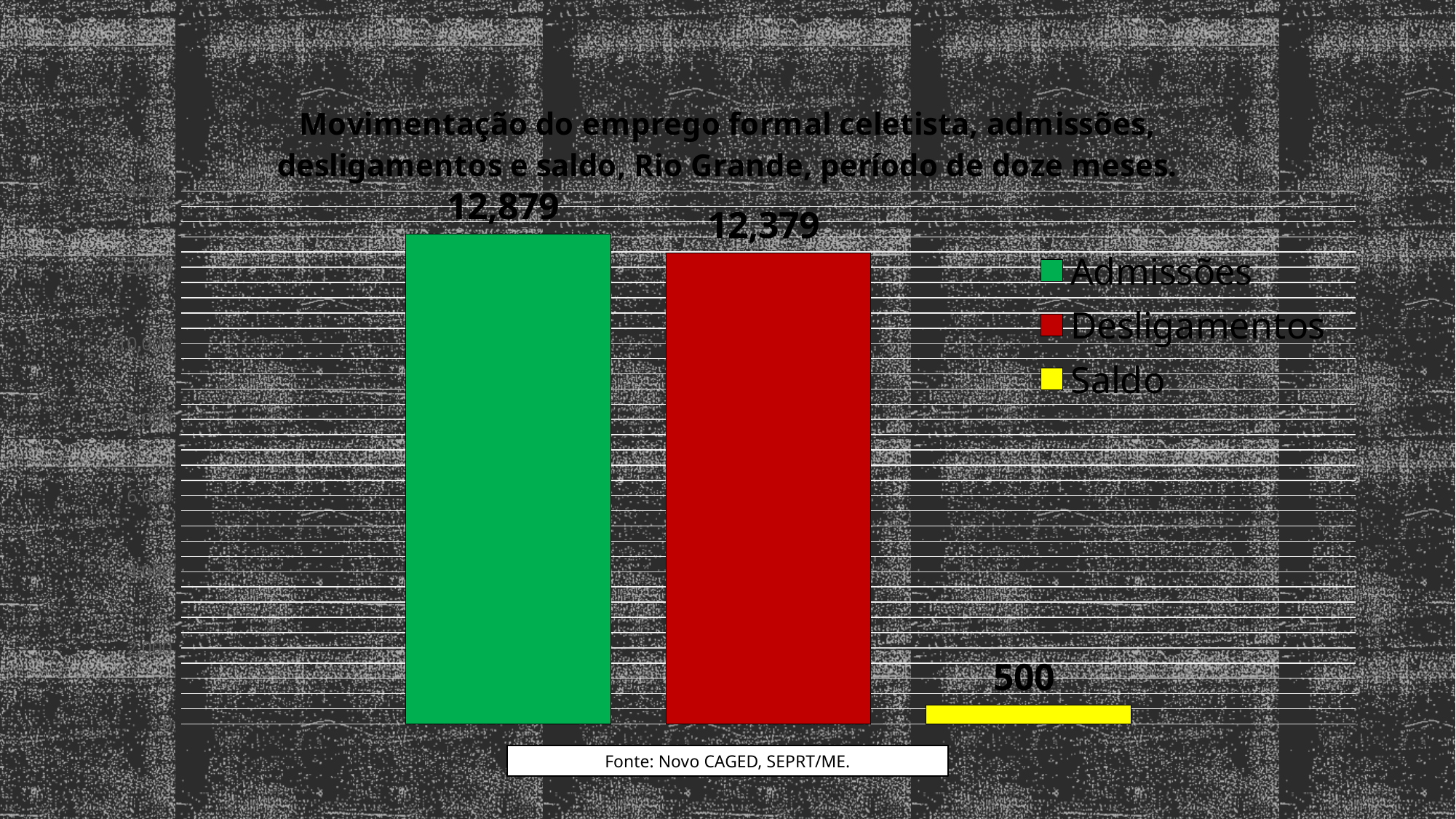
Which is larger, Desligamentos or Saldo? Desligamentos What kind of chart is shown? Bar chart Which is larger, Admissões or Desligamentos? Admissões What colour is the bar for Saldo? Yellow Which series has the highest value? Admissões What source is cited below the chart? Novo CAGED, SEPRT/ME. What is the value for Saldo? 500 How many series does the legend list? 3 Which series has the lowest value? Saldo What is the value for Admissões? 12,879 What is the difference between Admissões and Desligamentos? 500 What is the value for Desligamentos? 12,379